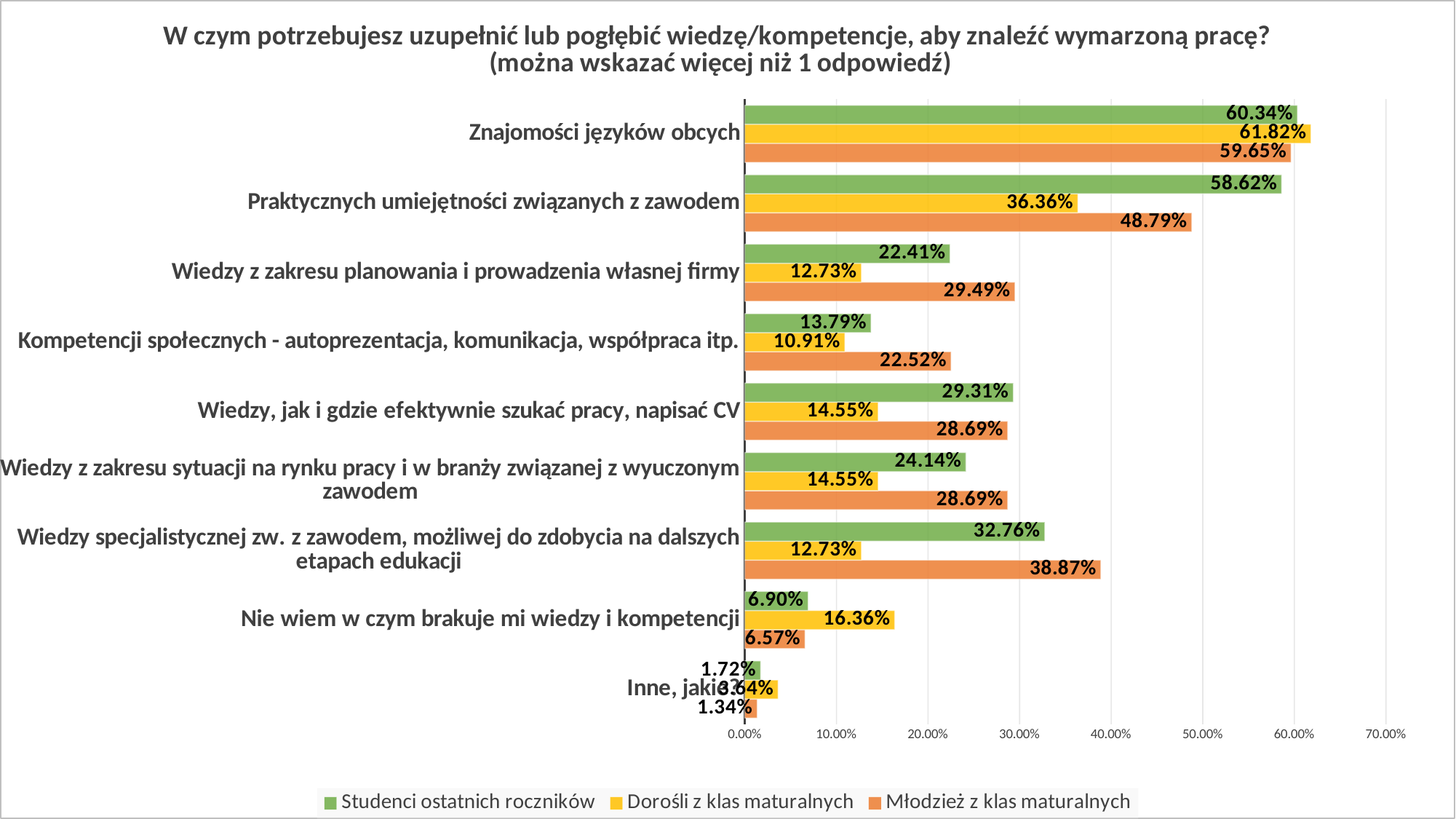
What is the value for Studenci ostatnich roczników in the category Praktycznych umiejętności związanych z zawodem? 58.62% Is the value for Młodzież z klas maturalnych in the category Kompetencji społecznych - autoprezentacja, komunikacja, współpraca itp. greater or less than 20.00%? greater Which category has the lowest value for Młodzież z klas maturalnych? Inne, jakie? In the category Praktycznych umiejętności związanych z zawodem, how much higher is the value for Studenci ostatnich roczników than for Dorośli z klas maturalnych? 22.26 percentage points What is the value for Młodzież z klas maturalnych in the category Wiedzy specjalistycznej zw. z zawodem, możliwej do zdobycia na dalszych etapach edukacji? 38.87% What is the value for Dorośli z klas maturalnych in the category Nie wiem w czym brakuje mi wiedzy i kompetencji? 16.36% What kind of chart is shown on the slide? bar chart How many series does the legend list? 3 In the category Wiedzy z zakresu planowania i prowadzenia własnej firmy, which series has the larger value: Studenci ostatnich roczników or Młodzież z klas maturalnych? Młodzież z klas maturalnych Which colour represents the series Dorośli z klas maturalnych? yellow Which category has the highest value for Dorośli z klas maturalnych? Znajomości języków obcych How many categories are shown on the chart? 9